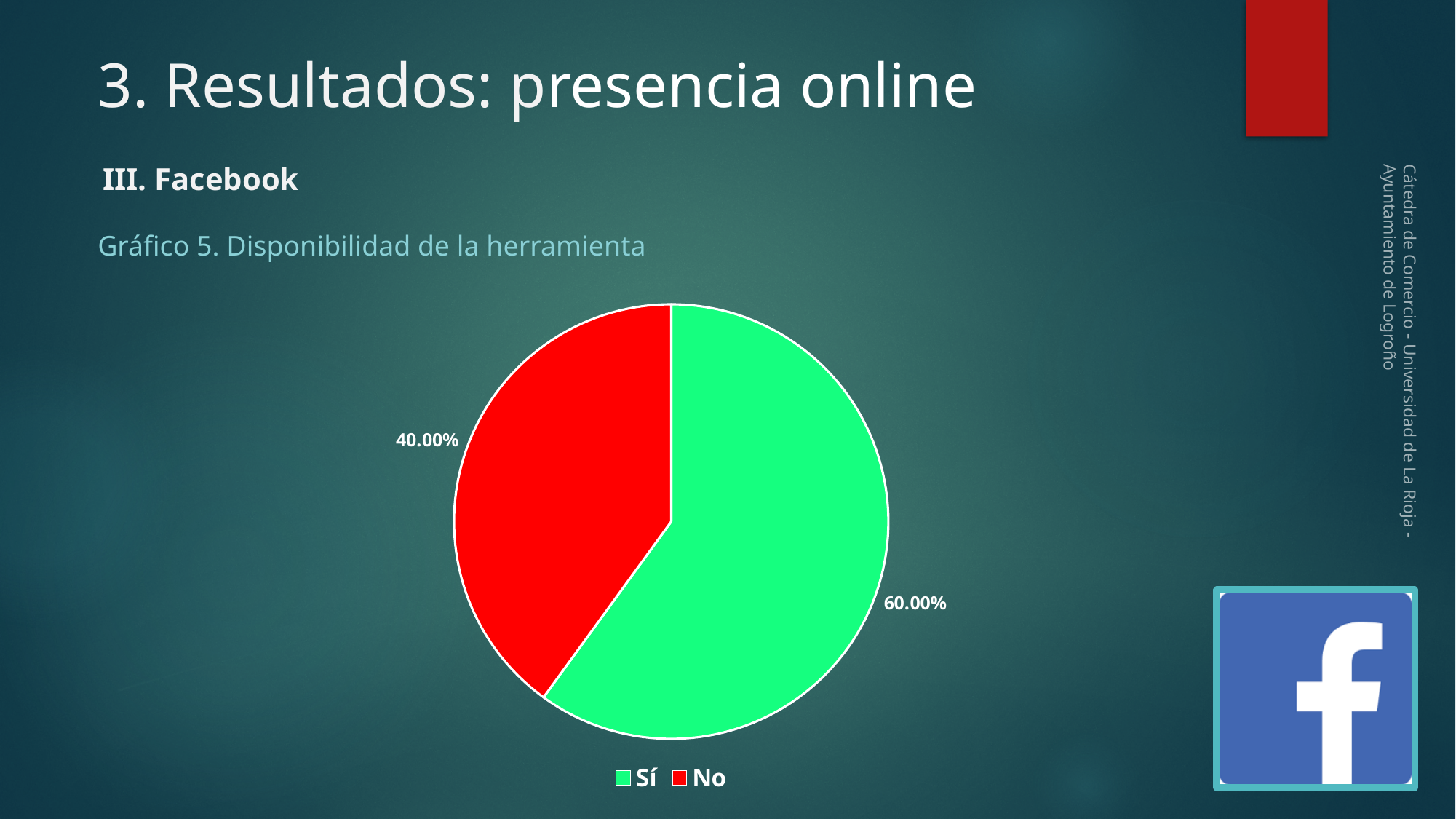
What share of the pie does the No slice represent? 40.00% Which is larger, the share for Sí or the share for No? Sí What is the title of the chart? Gráfico 5. Disponibilidad de la herramienta Which category has the smallest share of the pie? No What is the difference between the Sí and No shares? 20.00% Which category has the largest share of the pie? Sí What type of chart is shown on the slide? pie chart How many entries does the legend list? 2 How many slices does the pie chart have? 2 What is the value for No? 40.00% What is the value for Sí? 60.00% What colour is the Sí slice? green